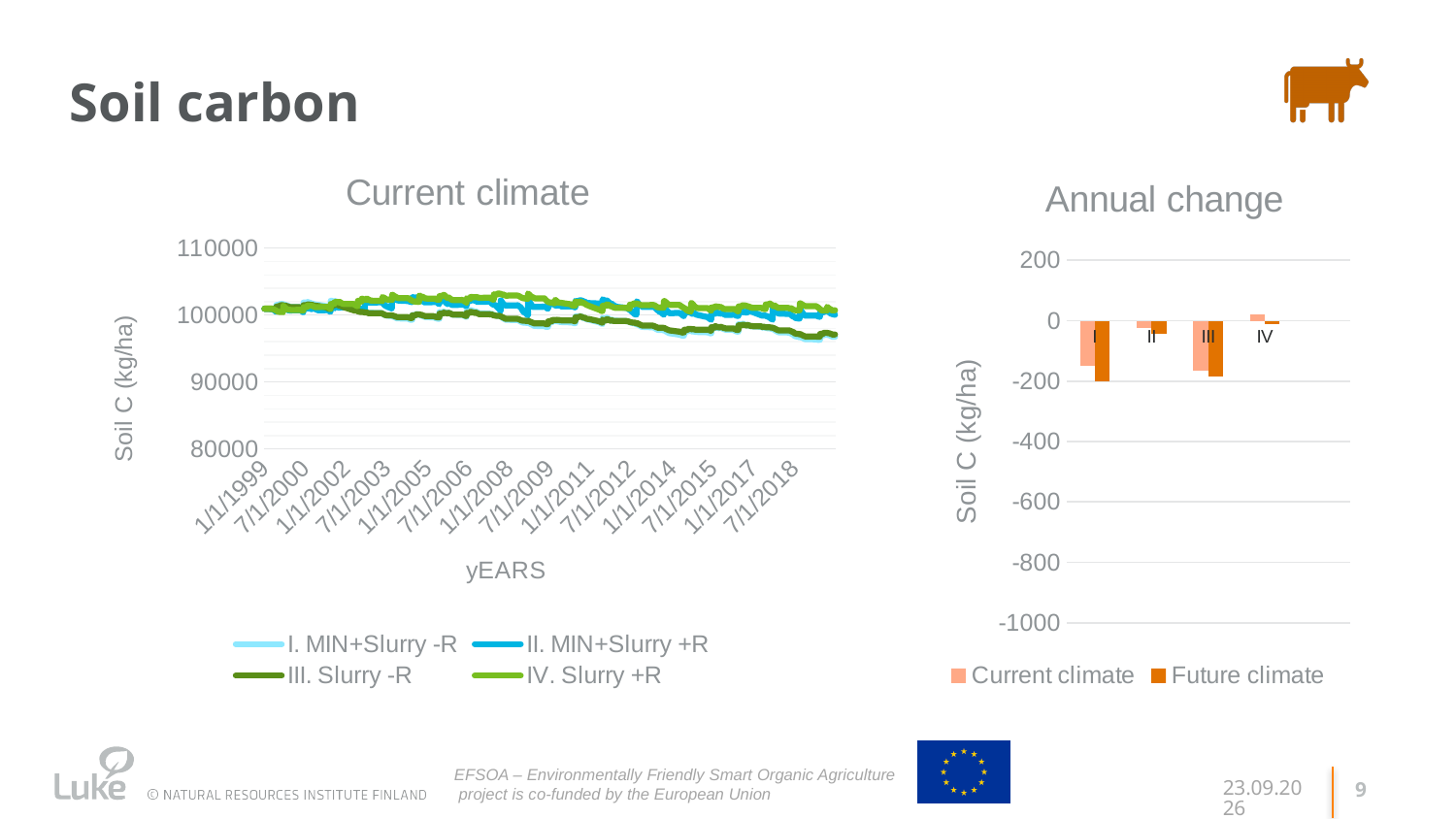
What is the y-axis label of the "Current climate" chart? Soil C (kg/ha) What kind of chart is the "Annual change" chart? bar chart How many series does the legend of the "Current climate" chart list? 4 In the "Annual change" chart, which is larger for category I: the Current climate value or the Future climate value? Current climate What kind of chart is the "Current climate" chart? line chart How many categories are shown on the x axis of the "Annual change" chart? 4 In the "Annual change" chart, is the Future climate value for category I greater or less than -100? less How many series does the legend of the "Annual change" chart list? 2 In the "Annual change" chart, is the Current climate value for category II greater or less than -200? greater What are the two legend entries of the "Annual change" chart? Current climate, Future climate In the "Annual change" chart, which category has the lowest Future climate value? I In the "Current climate" chart, does the III. Slurry -R series rise or fall over the years shown? fall